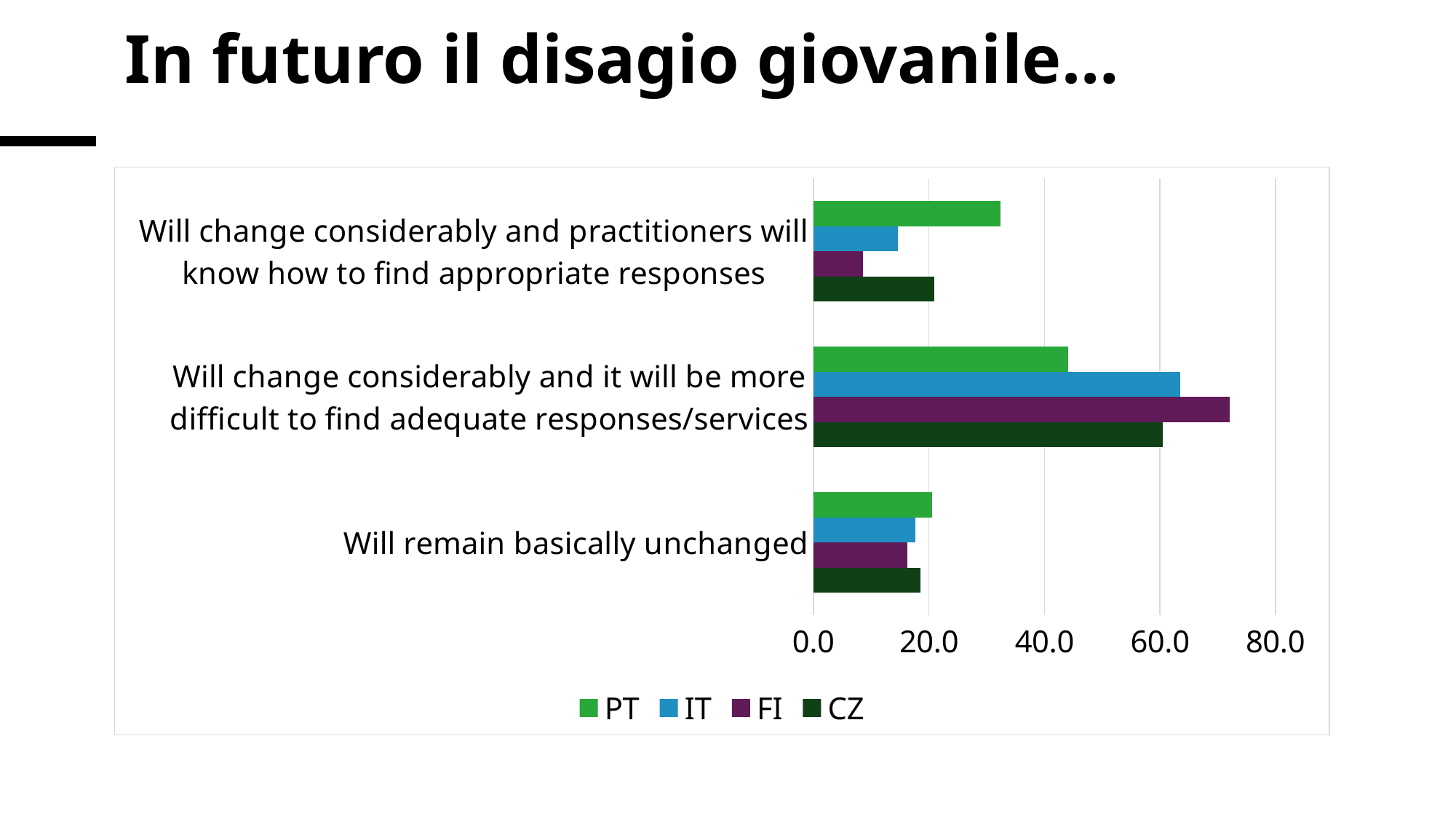
Which series has the highest value for 'Will change considerably and it will be more difficult to find adequate responses/services'? FI Is the value for PT in 'Will change considerably and practitioners will know how to find appropriate responses' greater or less than 20.0? greater Is the value for PT in 'Will change considerably and it will be more difficult to find adequate responses/services' greater or less than 40.0? greater Is the value for IT in 'Will change considerably and practitioners will know how to find appropriate responses' greater or less than 20.0? less What kind of chart is shown on the slide? bar chart How many series does the legend list? 4 For 'Will change considerably and practitioners will know how to find appropriate responses', which is larger: PT or IT? PT What are the series names listed in the legend? PT, IT, FI, CZ How many categories are shown on the chart? 3 Which series has the lowest value for 'Will change considerably and practitioners will know how to find appropriate responses'? FI For 'Will change considerably and it will be more difficult to find adequate responses/services', which is larger: FI or CZ? FI